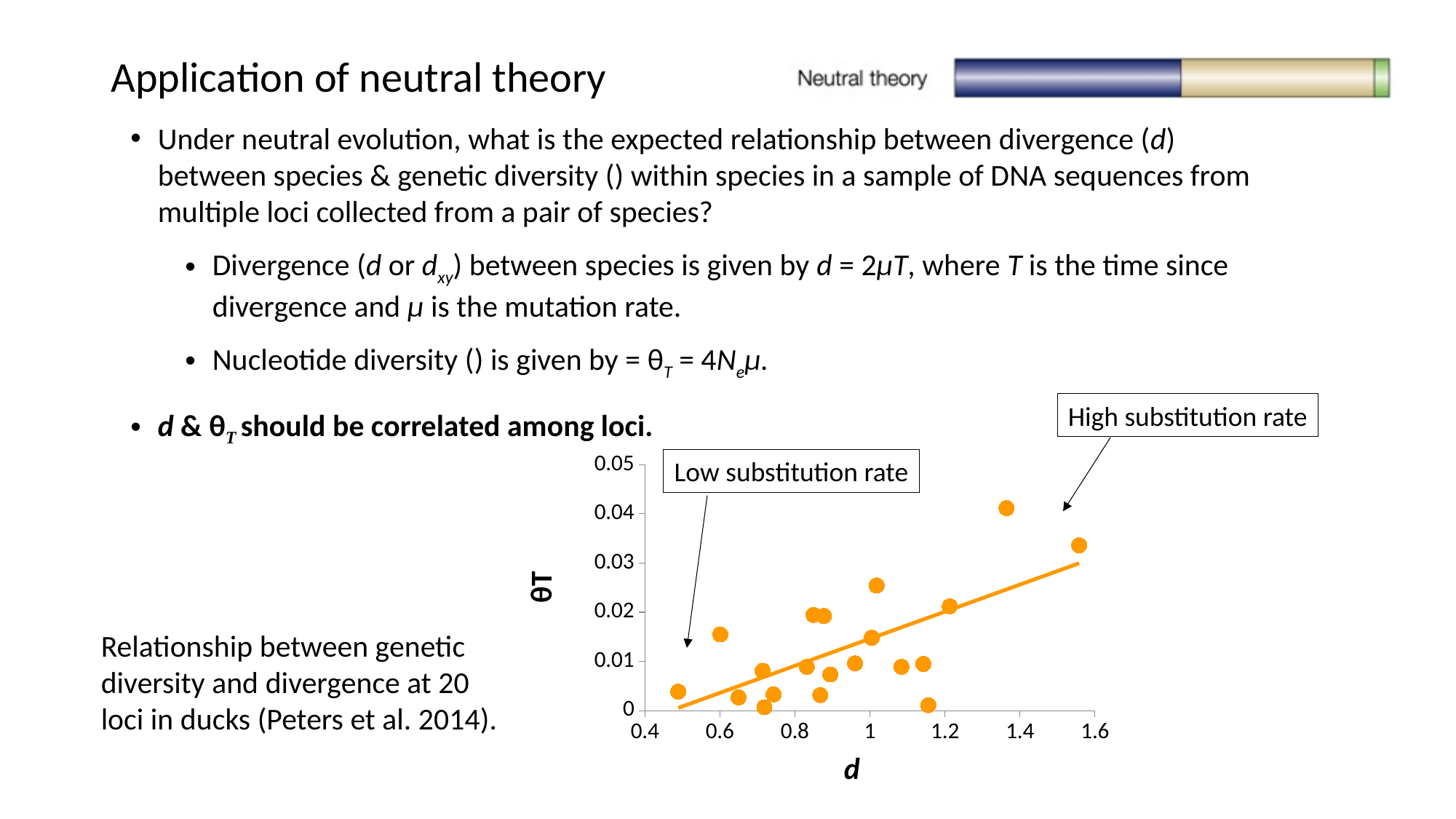
Is the d value of the rightmost point greater or less than 1.4? greater What is the maximum value shown on the y axis of the chart? 0.05 What is the label of the y axis of the chart? θT Does θT tend to rise or fall as d increases along the x axis? rise What kind of chart is shown on the slide? scatter plot Is the θT value of the point at d ≈ 1.55 greater or less than 0.03? greater Is the θT value of the point at d ≈ 0.6 greater or less than 0.02? less Which has the higher θT value: the point at d ≈ 1.36 or the point at d ≈ 1.21? the point at d ≈ 1.36 What is the label of the x axis of the chart? d How many data points (loci) are plotted in the chart? 20